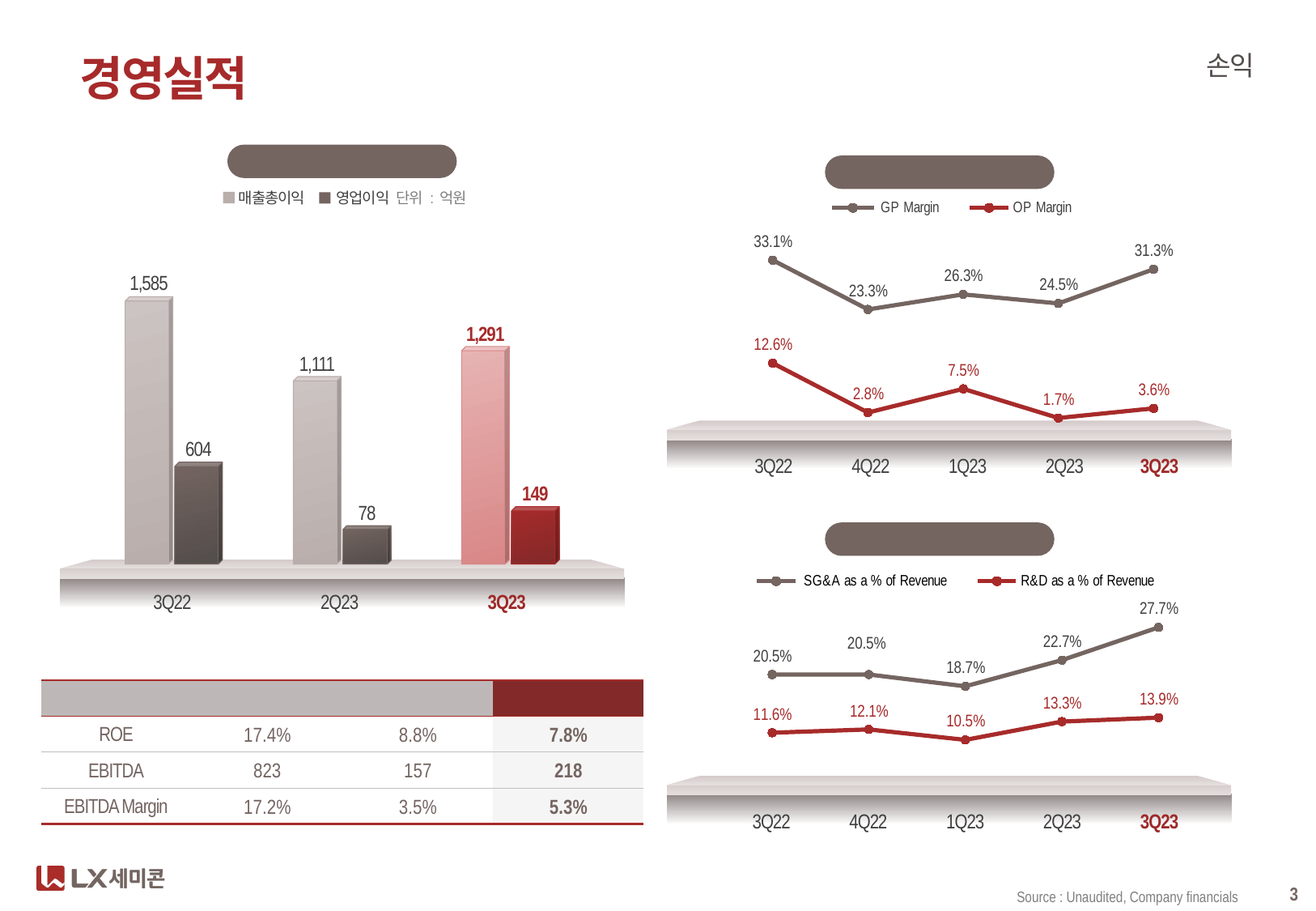
In the bar chart on the left, how many series does the legend list? 2 In the top-right line chart, which is larger: GP Margin in 3Q22 or GP Margin in 3Q23? 3Q22 In the bar chart on the left, which quarter has the lowest 영업이익? 2Q23 In the bottom-right line chart, what is R&D as a % of Revenue for 1Q23? 10.5% In the bar chart on the left, what is the 매출총이익 value for 3Q22? 1,585 In the top-right line chart, which quarter has the lowest OP Margin? 2Q23 In the top-right line chart, what is the GP Margin for 1Q23? 26.3% In the bottom-right line chart, how many quarters are shown on the x axis? 5 In the bar chart on the left, what is the difference between 매출총이익 in 3Q22 and 2Q23? 474 In the bottom-right line chart, which quarter has the highest SG&A as a % of Revenue? 3Q23 In the bar chart on the left, what is the 영업이익 value for 3Q23? 149 What kind of chart is the chart on the left of the slide? Bar chart